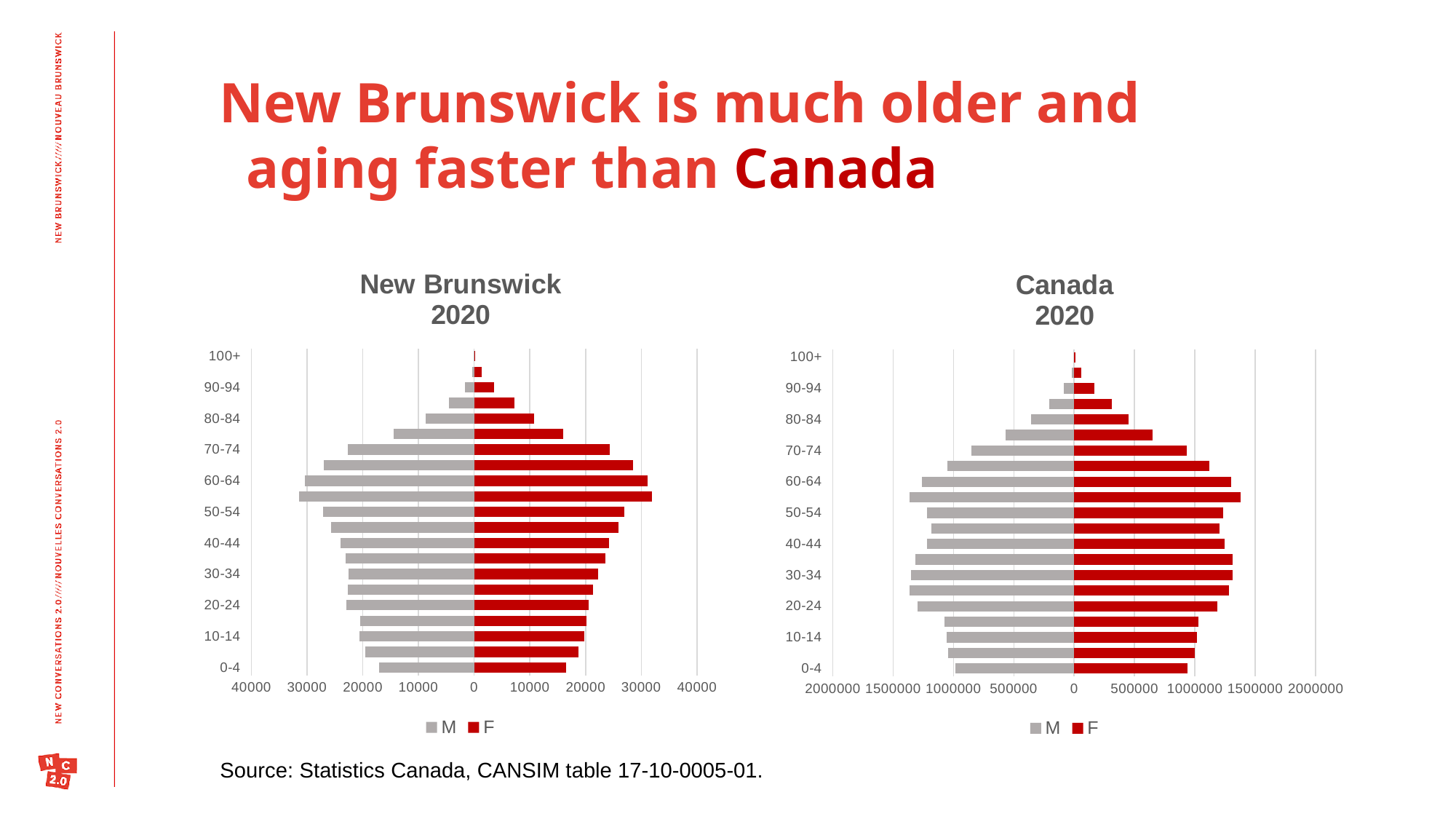
In the New Brunswick 2020 chart, which series has the larger value for the 80-84 age group, M or F? F In the Canada 2020 chart, is the M value for the 80-84 age group greater or less than 500000? less In the Canada 2020 chart, which colour represents the F series? red In the New Brunswick 2020 chart, is the F value for the 0-4 age group greater or less than 20000? less In the New Brunswick 2020 chart, is the F value for the 70-74 age group greater or less than 20000? greater What kind of chart is the New Brunswick 2020 chart? bar chart How many series does the legend of the Canada 2020 chart list? 2 In the New Brunswick 2020 chart, which F age group has the larger value, 60-64 or 0-4? 60-64 In the Canada 2020 chart, which F age group has the larger value, 60-64 or 0-4? 60-64